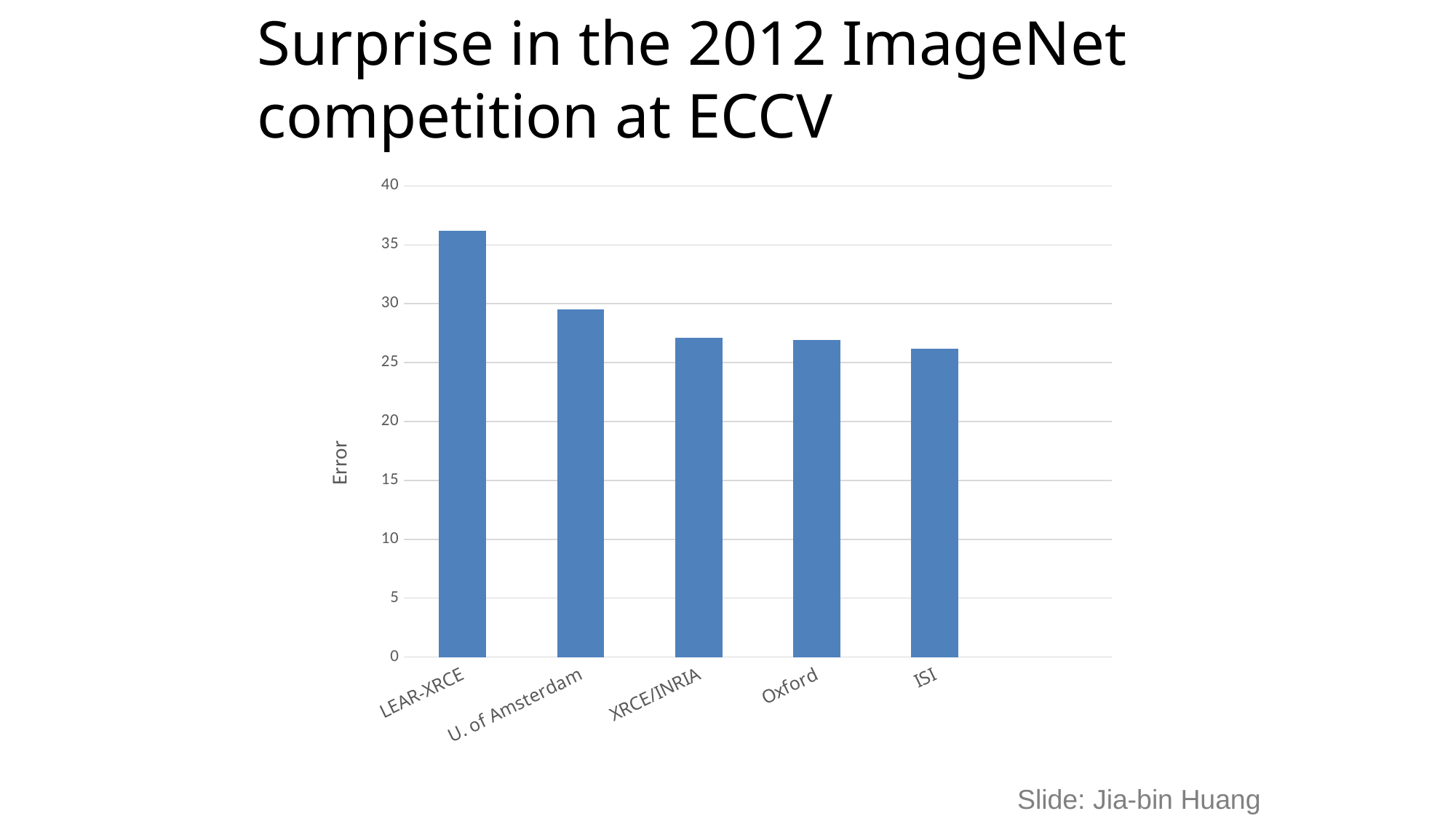
Which has a higher error, U. of Amsterdam or ISI? U. of Amsterdam Do the error values rise or fall from left to right across the chart? fall Is the error for U. of Amsterdam greater or less than 30? less What is the label on the vertical axis of the chart? Error Is the error for XRCE/INRIA greater or less than 30? less Is the error for ISI greater or less than 25? greater Which team has the highest error in the chart? LEAR-XRCE Which has a higher error, LEAR-XRCE or ISI? LEAR-XRCE How many teams (categories) are shown in the chart? 5 What kind of chart is shown on the slide? bar chart